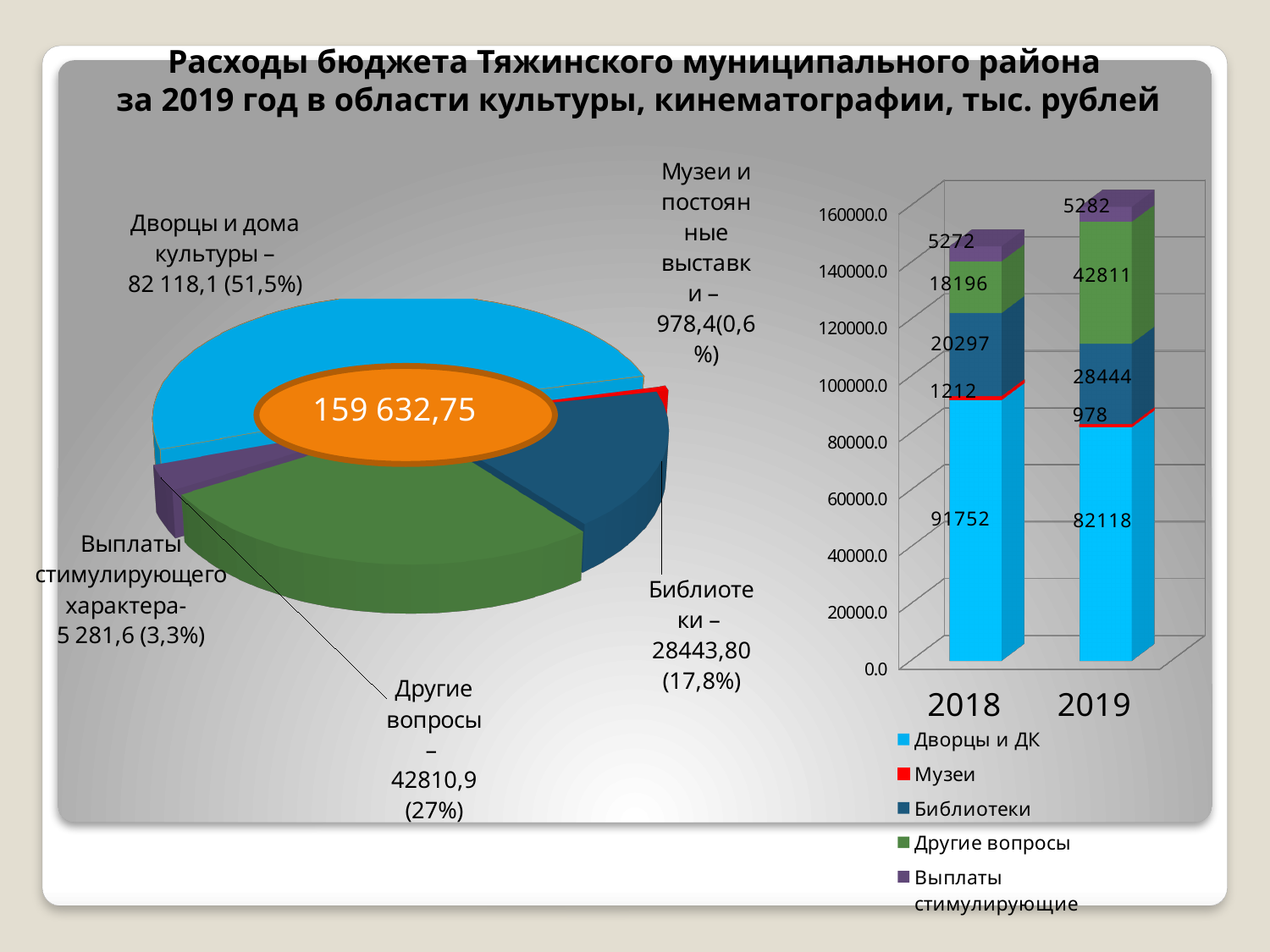
In the pie chart on the left, what total value is shown in the centre of the pie? 159 632,75 In the stacked bar chart on the right, what is the value for Библиотеки in 2019? 28444 In the pie chart on the left, which category has the smallest share? Музеи и постоянные выставки In the stacked bar chart on the right, what is the total of the 2019 bar? 159633 In the pie chart on the left, how many slices (categories) are there? 5 In the stacked bar chart on the right, how many series does the legend list? 5 What type of chart is shown on the right side of the slide? Stacked bar chart In the stacked bar chart on the right, what is the difference between the Другие вопросы values for 2019 and 2018? 24615 In the pie chart on the left, what share of the pie is Библиотеки? 17,8% In the pie chart on the left, what is the value shown for Дворцы и дома культуры? 82 118,1 (51,5%) In the stacked bar chart on the right, what is the value for Дворцы и ДК in 2018? 91752 In the stacked bar chart on the right, which year has the larger value for Дворцы и ДК, 2018 or 2019? 2018